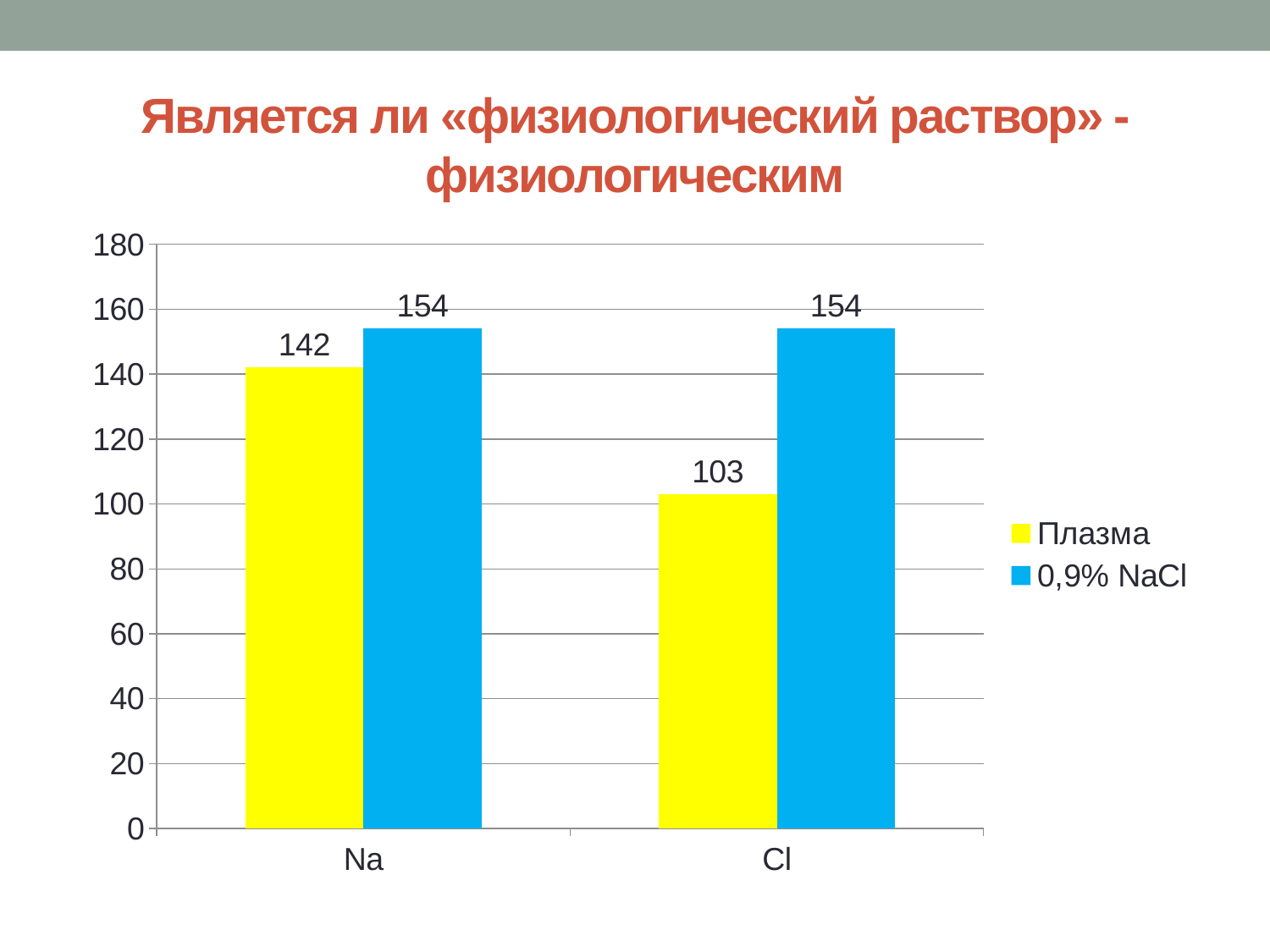
Which colour represents the Плазма series? yellow What is the value for Плазма in the Cl category? 103 What is the value for Плазма in the Na category? 142 Which category has the lowest Плазма value? Cl What kind of chart is shown on the slide? bar chart What is the value for 0,9% NaCl in the Cl category? 154 Is the Плазма value for Cl greater or less than 120? less What is the difference between the 0,9% NaCl and Плазма values for Na? 12 How many categories are shown on the x axis? 2 How many series does the legend list? 2 Which is larger for Na: the Плазма value or the 0,9% NaCl value? 0,9% NaCl What is the difference between the 0,9% NaCl and Плазма values for Cl? 51